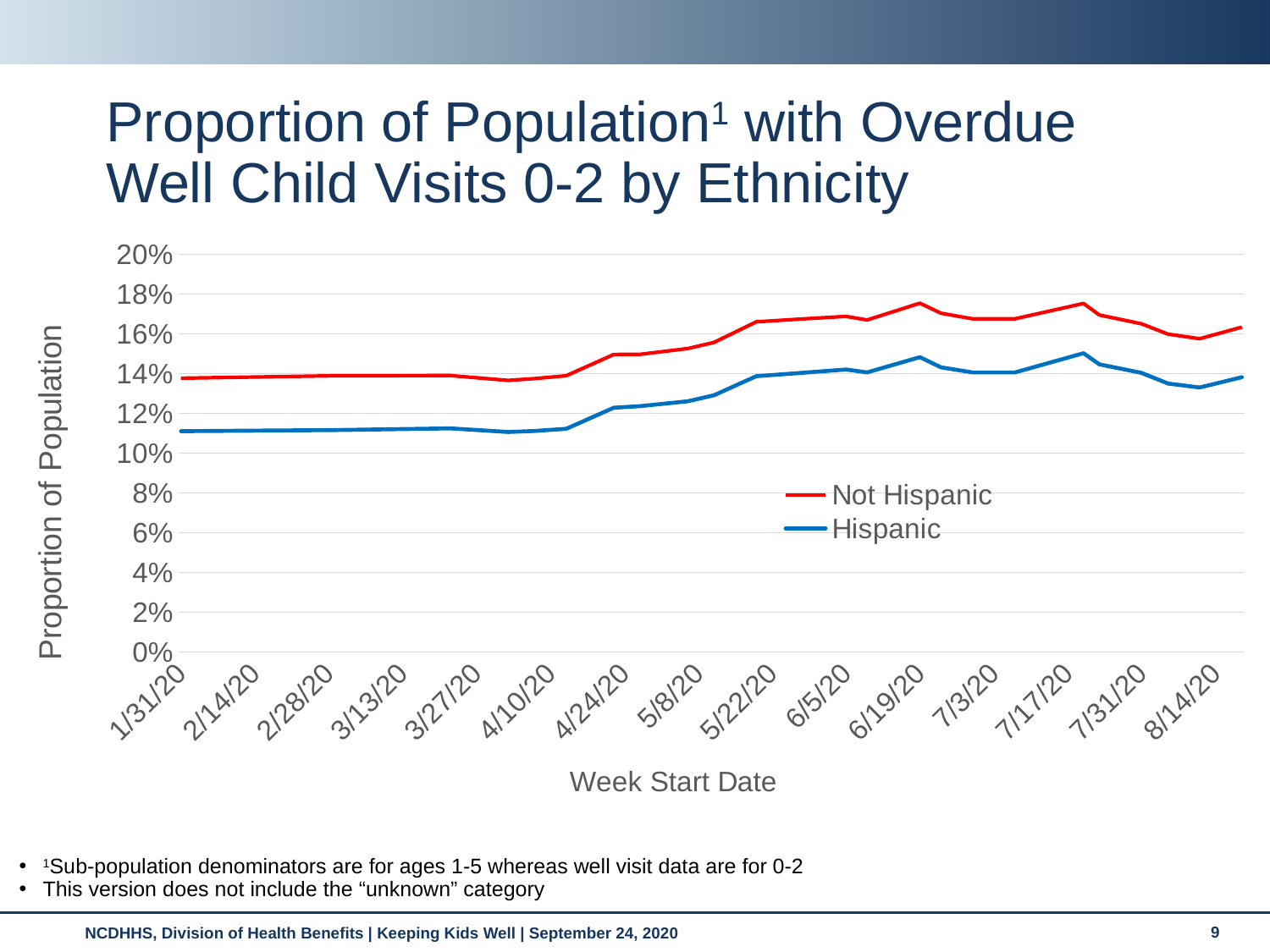
Is the Not Hispanic value at 6/19/20 greater or less than 16%? greater Is the Hispanic value at 6/19/20 greater or less than 14%? greater How many series does the legend list? 2 What is the title of the x axis? Week Start Date Is the Hispanic value at 1/31/20 greater or less than 12%? less What kind of chart is shown on the slide? line chart Which series is shown in red? Not Hispanic How many week start dates are labeled on the x axis? 15 Overall, does the Hispanic line rise or fall from 1/31/20 to 8/14/20? rise At 5/22/20, which series has the higher value, Not Hispanic or Hispanic? Not Hispanic